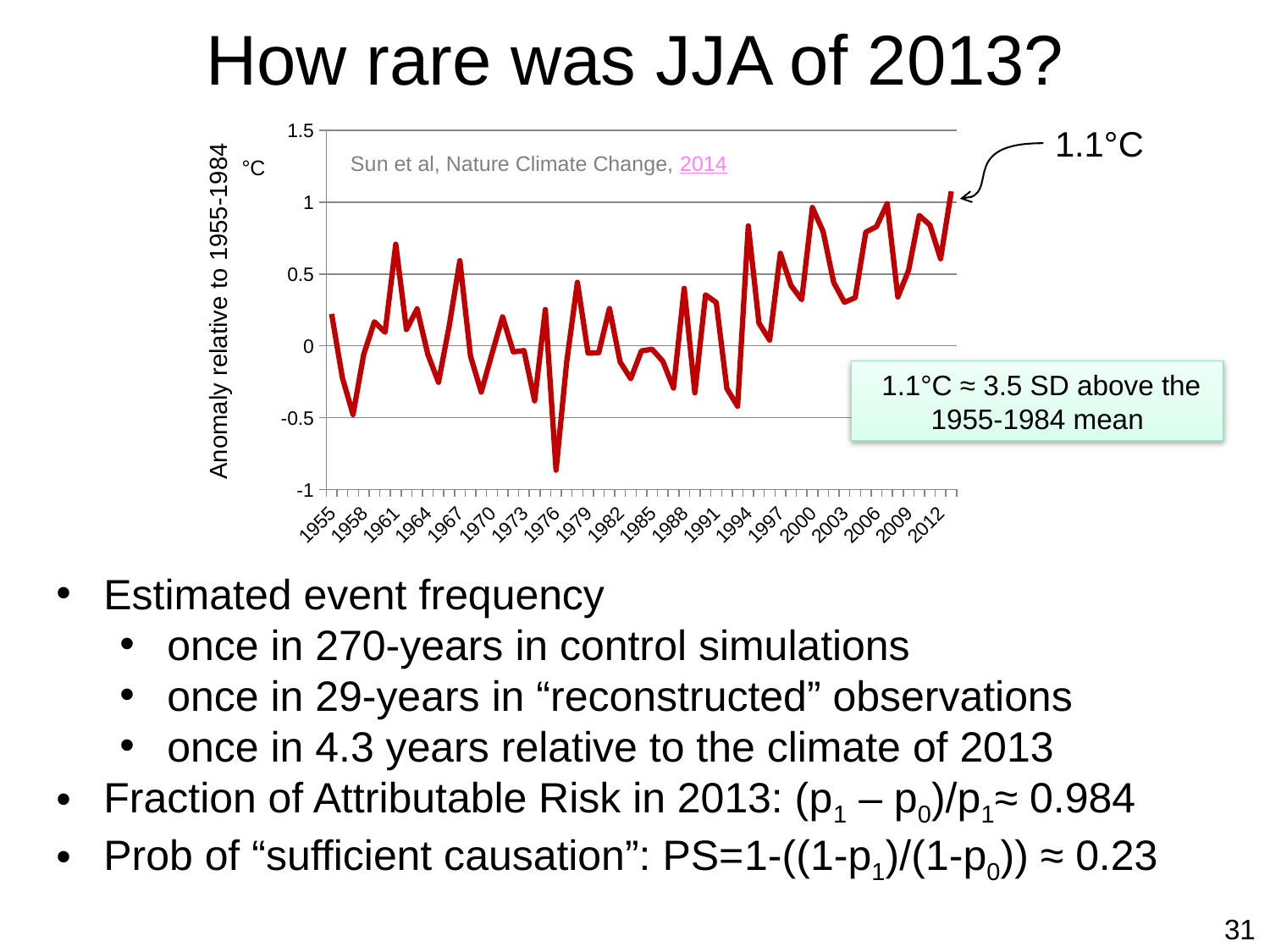
Which year has the highest anomaly on the chart? 2013 What is the label on the vertical axis of the chart? Anomaly relative to 1955-1984 Is the anomaly value for 1976 greater or less than -0.5? less According to the text box on the chart, how many standard deviations above the 1955-1984 mean is 1.1°C? 3.5 SD What is the anomaly value annotated for the final point (2013) on the chart? 1.1°C Do the anomaly values generally rise or fall from 1955 to 2013? rise What kind of chart is shown on the slide? line chart Which year has the larger anomaly, 1961 or 1976? 1961 Is the anomaly value for 2013 greater or less than 1? greater Is the anomaly value for 1961 greater or less than 0.5? greater Which year has the larger anomaly, 1955 or 1994? 1994 Which year has the lowest anomaly on the chart? 1976